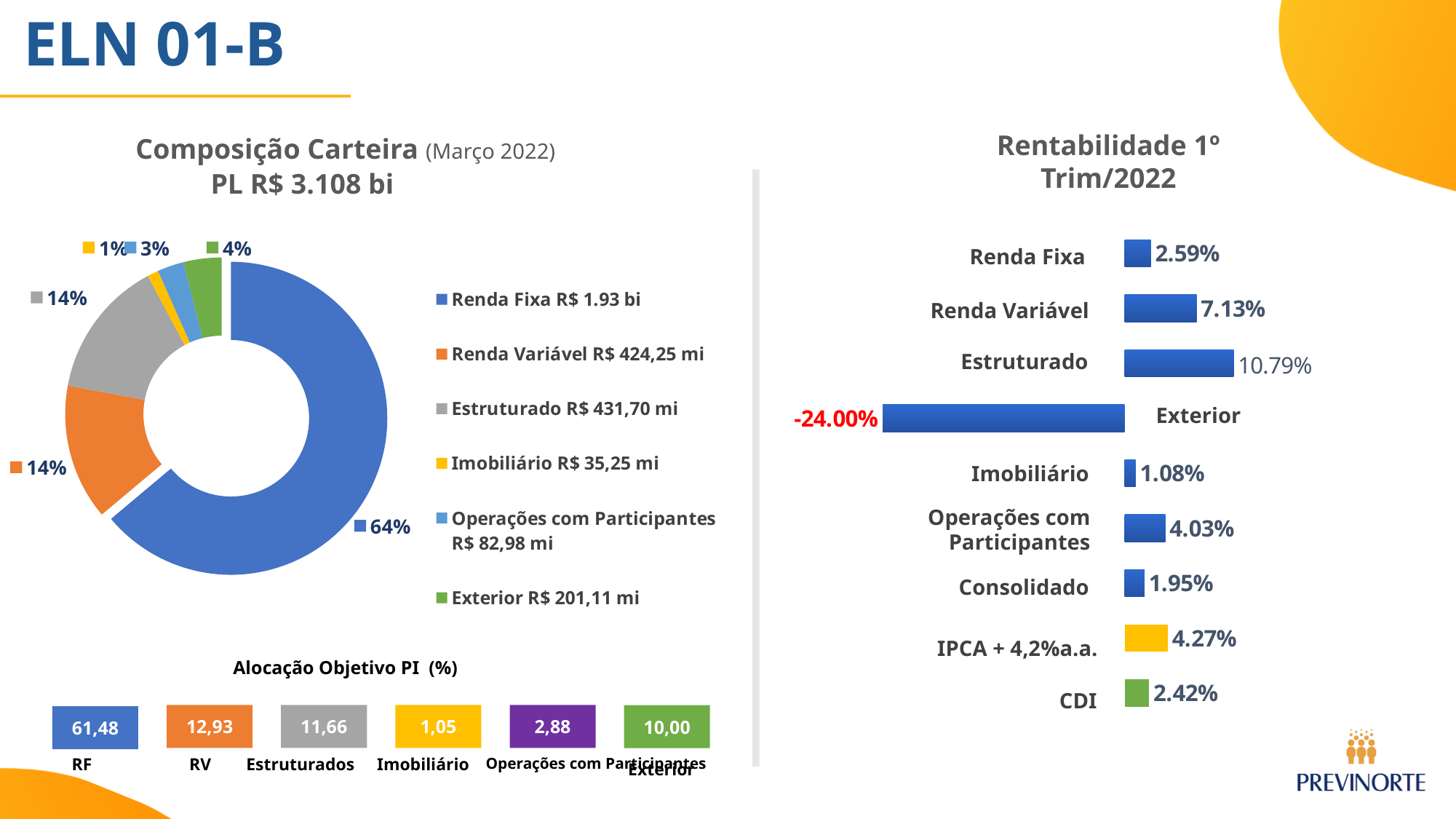
In the 'Rentabilidade 1º Trim/2022' chart, which category has the lowest value? Exterior In the 'Rentabilidade 1º Trim/2022' chart, which category has the highest value? Estruturado In the 'Rentabilidade 1º Trim/2022' chart, what is the value for Estruturado? 10.79% How many categories does the 'Composição Carteira' donut chart show? 6 In the 'Rentabilidade 1º Trim/2022' chart, which is larger: Renda Variável or Renda Fixa? Renda Variável In the 'Composição Carteira' donut chart, which category has the smallest share? Imobiliário In the 'Composição Carteira' donut chart, what share does Exterior hold? 4% In the 'Composição Carteira' donut chart, what share does Renda Fixa hold? 64% In the 'Rentabilidade 1º Trim/2022' chart, what is the value for Exterior? -24.00% In the 'Composição Carteira' legend, what value is shown for Renda Variável? R$ 424,25 mi In the 'Rentabilidade 1º Trim/2022' chart, what is the difference between IPCA + 4,2%a.a. and CDI? 1.85% In the 'Alocação Objetivo PI (%)' chart, what is the value for Estruturados? 11,66